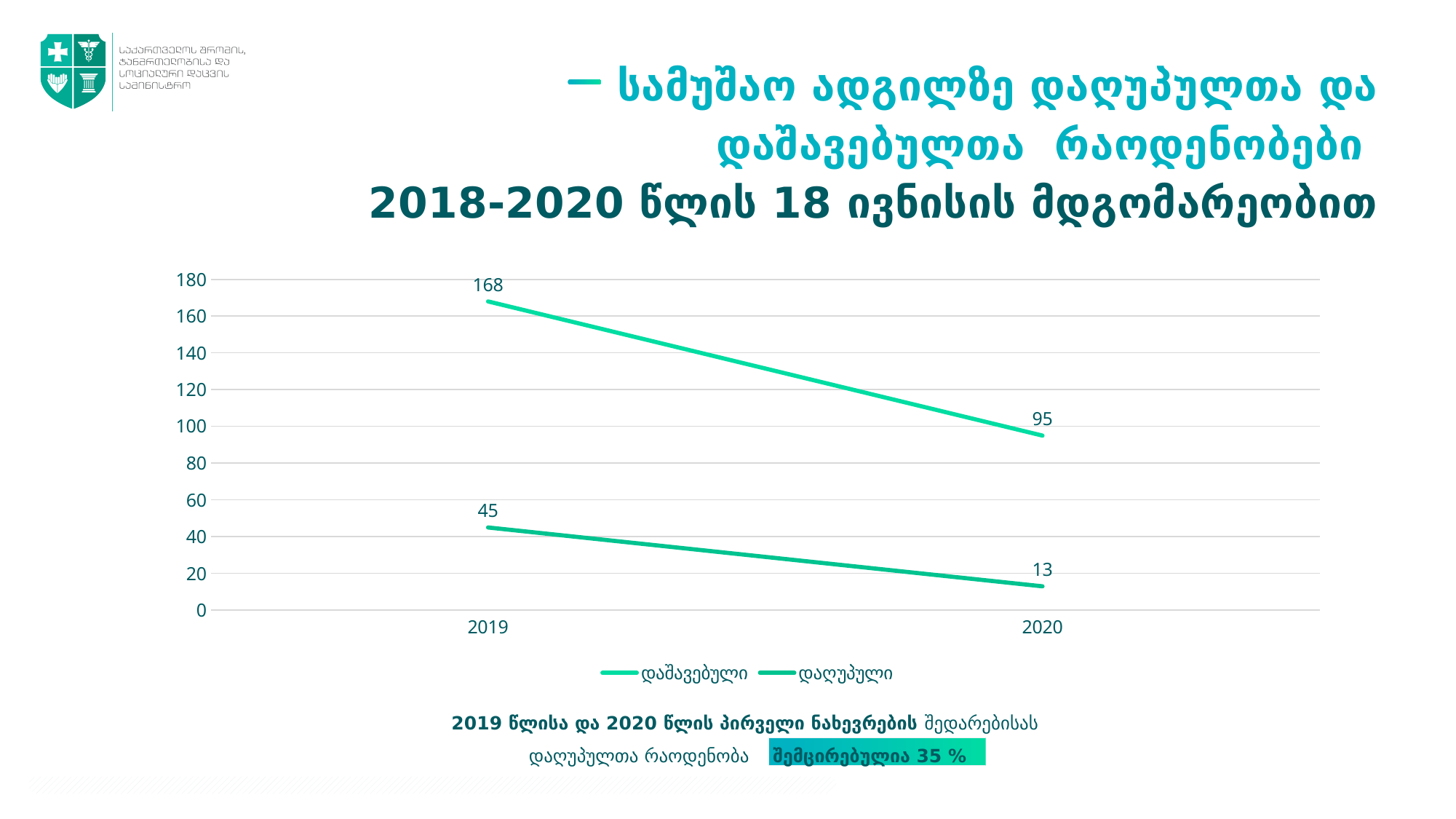
What is the value for დაშავებული in 2019? 168 What type of chart is shown on the slide? Line chart By how much did the value for დაშავებული decrease from 2019 to 2020? 73 How many series does the legend list? 2 Which series is drawn in the darker green line? დაღუპული What is the value for დაღუპული in 2019? 45 What is the value for დაღუპული in 2020? 13 What is the value for დაშავებული in 2020? 95 Which series has the higher value in 2019, დაშავებული or დაღუპული? დაშავებული How many years are shown on the x axis? 2 Does the value for დაღუპული rise or fall from 2019 to 2020? Fall What is the difference between დაშავებული and დაღუპული in 2020? 82